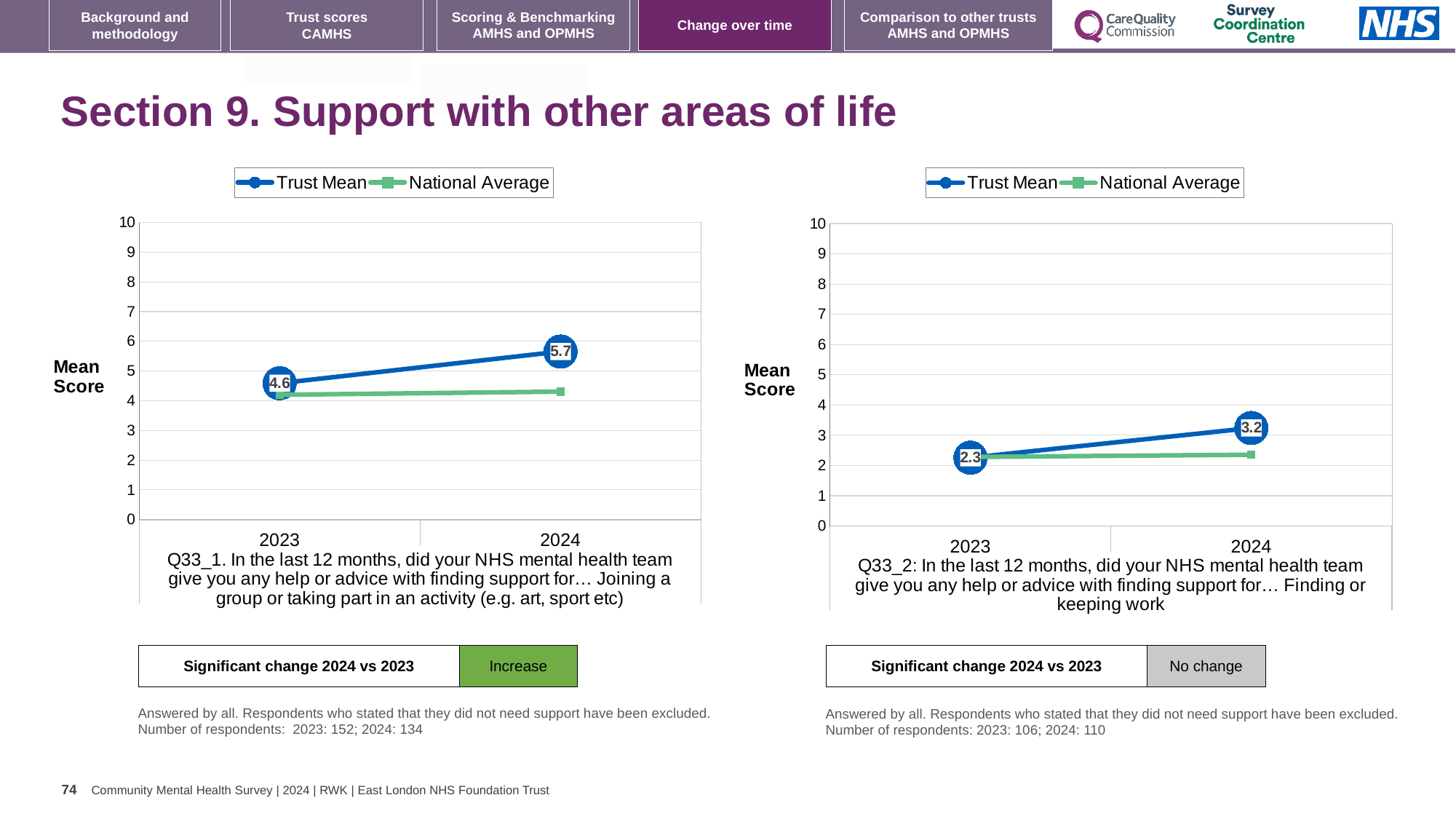
On the left chart (Q33_1), what is the Trust Mean for 2024? 5.7 On the left chart (Q33_1), by how much did the Trust Mean change from 2023 to 2024? 1.1 On the left chart (Q33_1), does the Trust Mean rise or fall from 2023 to 2024? rise On the right chart (Q33_2), what is the Trust Mean for 2024? 3.2 On the left chart (Q33_1), what is the Trust Mean for 2023? 4.6 What type of chart is used on the right side of the slide (Q33_2)? line chart On the right chart (Q33_2), is the Trust Mean for 2024 greater or less than 4? less On the left chart (Q33_1), is the National Average for 2024 greater or less than 5? less On the right chart (Q33_2), which is larger in 2024, the Trust Mean or the National Average? Trust Mean On the right chart (Q33_2), what is the difference between the Trust Mean in 2024 and in 2023? 0.9 On the right chart (Q33_2), what is the Trust Mean for 2023? 2.3 How many series does the legend of the left chart list? 2